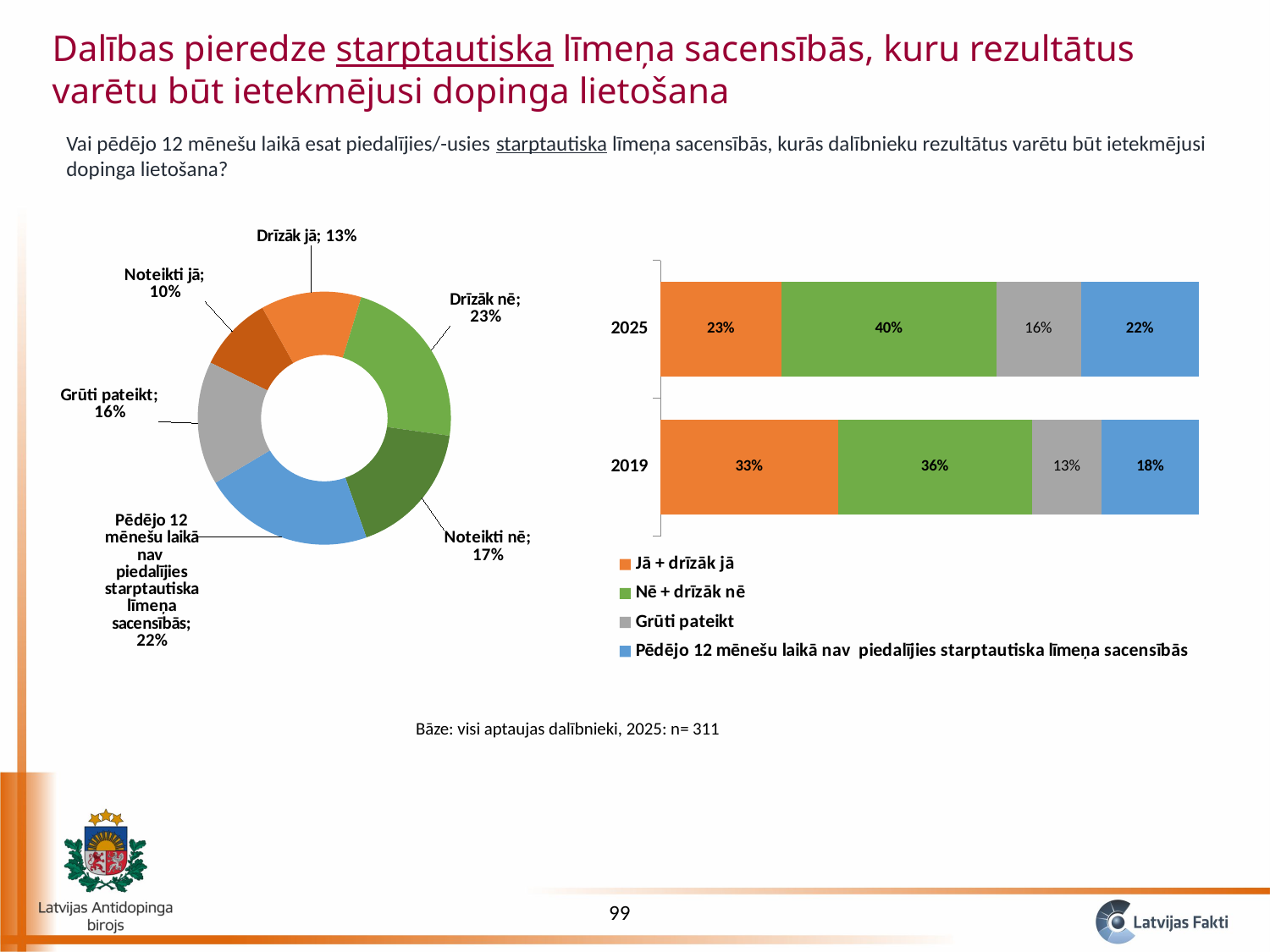
In the stacked bar chart on the right, which year has the larger value for "Grūti pateikt", 2025 or 2019? 2025 In the doughnut chart on the left, what is the difference between "Noteikti nē" and "Drīzāk jā"? 4% In the stacked bar chart on the right, what is the difference between the "Jā + drīzāk jā" values for 2019 and 2025? 10% In the stacked bar chart on the right, what is the value of "Jā + drīzāk jā" for 2019? 33% What type of chart is shown on the right side of the slide? Stacked bar chart In the stacked bar chart on the right, what is the value of "Nē + drīzāk nē" for 2025? 40% How many series does the legend of the stacked bar chart on the right list? 4 In the doughnut chart on the left, how many categories are shown? 6 In the doughnut chart on the left, which category has the highest value? Drīzāk nē In the doughnut chart on the left, what is the value for "Drīzāk nē"? 23% In the doughnut chart on the left, what is the value for "Noteikti jā"? 10% In the doughnut chart on the left, which category has the lowest value? Noteikti jā